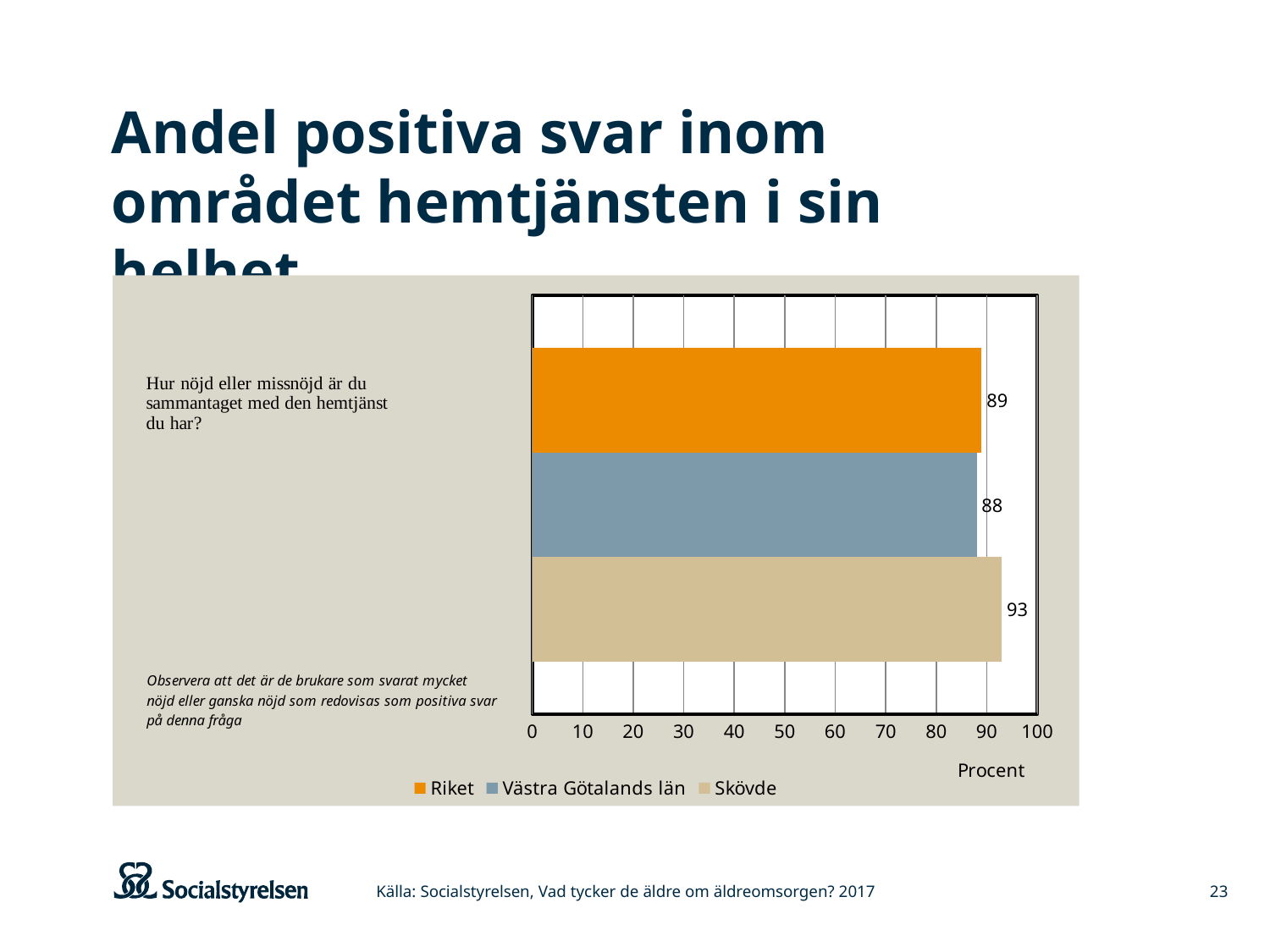
What value is shown for Riket? 89 Which series has the lowest value? Västra Götalands län What value is shown for Västra Götalands län? 88 Which is larger, the value for Skövde or the value for Västra Götalands län? Skövde What is the label of the horizontal axis? Procent What is the difference between the values for Skövde and Riket? 4 What is the difference between the values for Riket and Västra Götalands län? 1 How many series does the legend list? 3 Which series has the highest value? Skövde What value is shown for Skövde? 93 What kind of chart is shown on the slide? Bar chart Is the value for Skövde greater or less than 90? greater